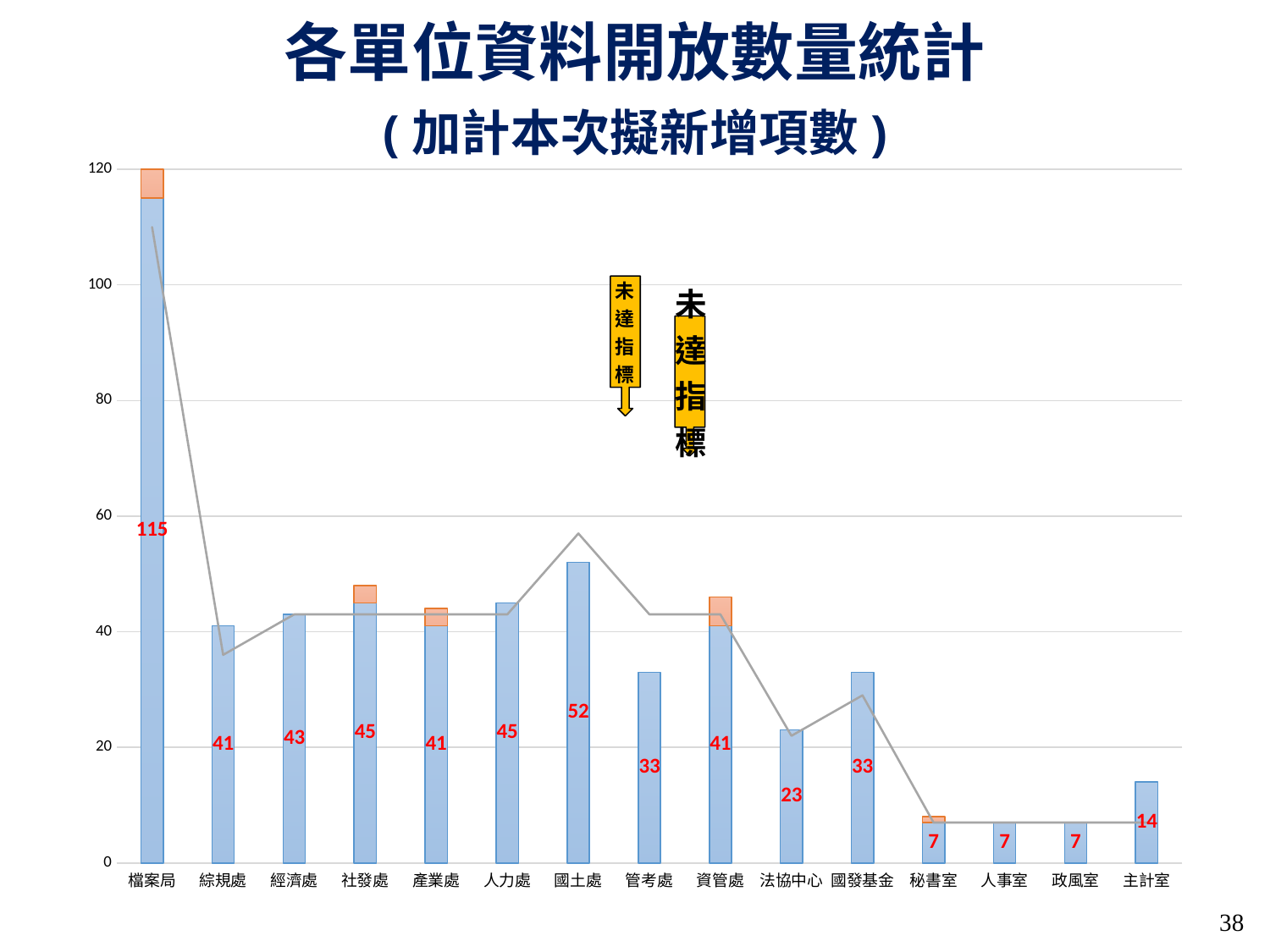
What is the value labeled for 檔案局? 115 How many units are shown on the x axis? 15 What is the difference between the values for 人力處 and 管考處? 12 What kind of chart is this? combination bar and line chart What is the value labeled for 主計室? 14 Which has a larger value, 綜規處 or 經濟處? 經濟處 Is the value for 主計室 greater or less than 20? less What is the value labeled for 法協中心? 23 What is the lowest labeled value on the chart? 7 Which unit has the highest value? 檔案局 What is the value labeled for 國土處? 52 What is the difference between the values for 檔案局 and 國土處? 63